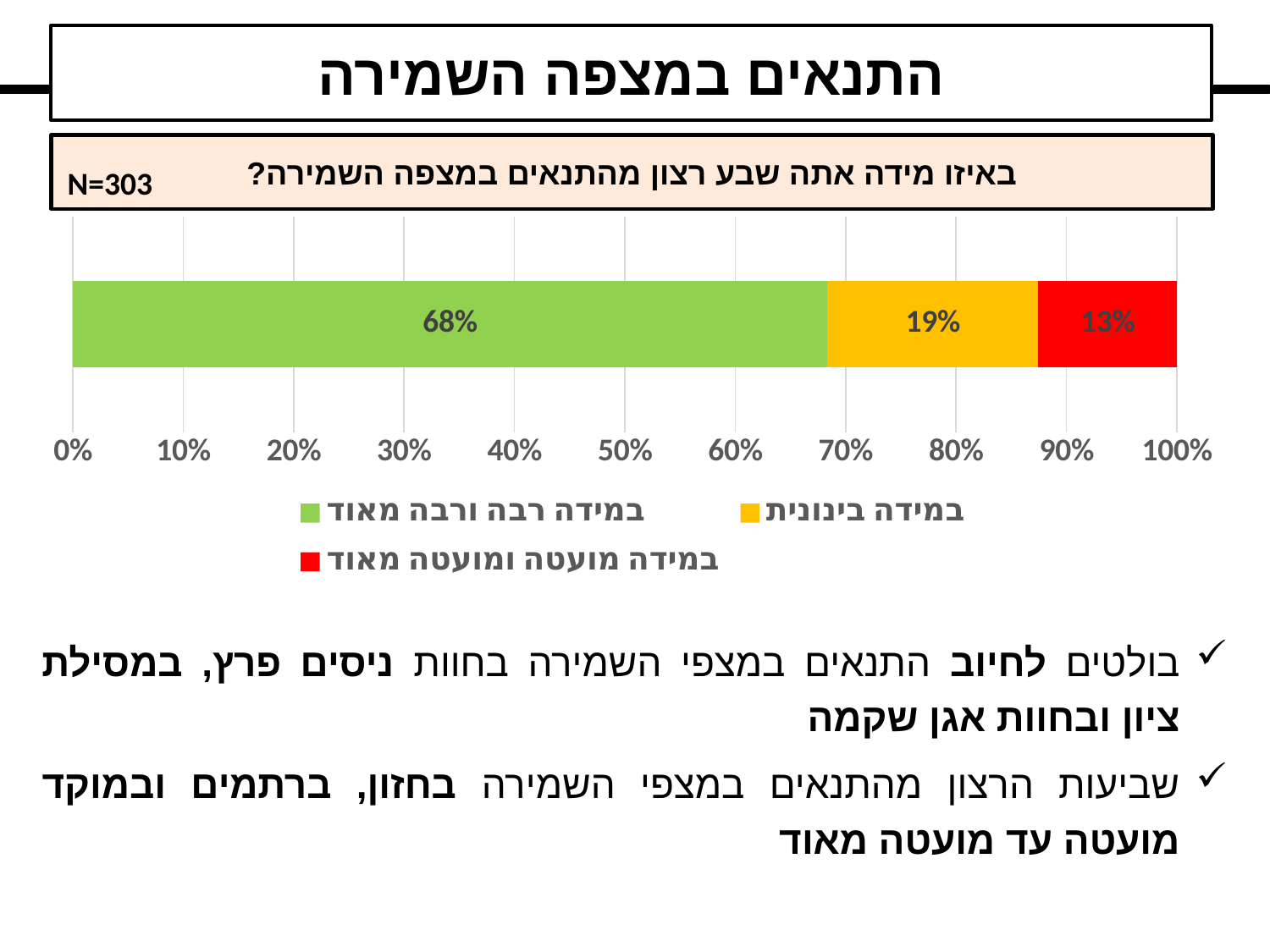
What percentage of respondents answered "במידה רבה ורבה מאוד"? 68% Which response category has the largest share? במידה רבה ורבה מאוד What percentage of respondents answered "במידה מועטה ומועטה מאוד"? 13% What percentage of respondents answered "במידה בינונית"? 19% Is the value for "במידה רבה ורבה מאוד" greater or less than 60%? greater What is the difference in percentage points between "במידה בינונית" and "במידה מועטה ומועטה מאוד"? 6 What kind of chart is shown on the slide? Stacked bar chart What is the sample size (N) shown on the slide? 303 How many series does the legend list? 3 Which is larger: the share for "במידה בינונית" or the share for "במידה מועטה ומועטה מאוד"? במידה בינונית Which response category has the smallest share? במידה מועטה ומועטה מאוד What is the difference in percentage points between "במידה רבה ורבה מאוד" and "במידה בינונית"? 49